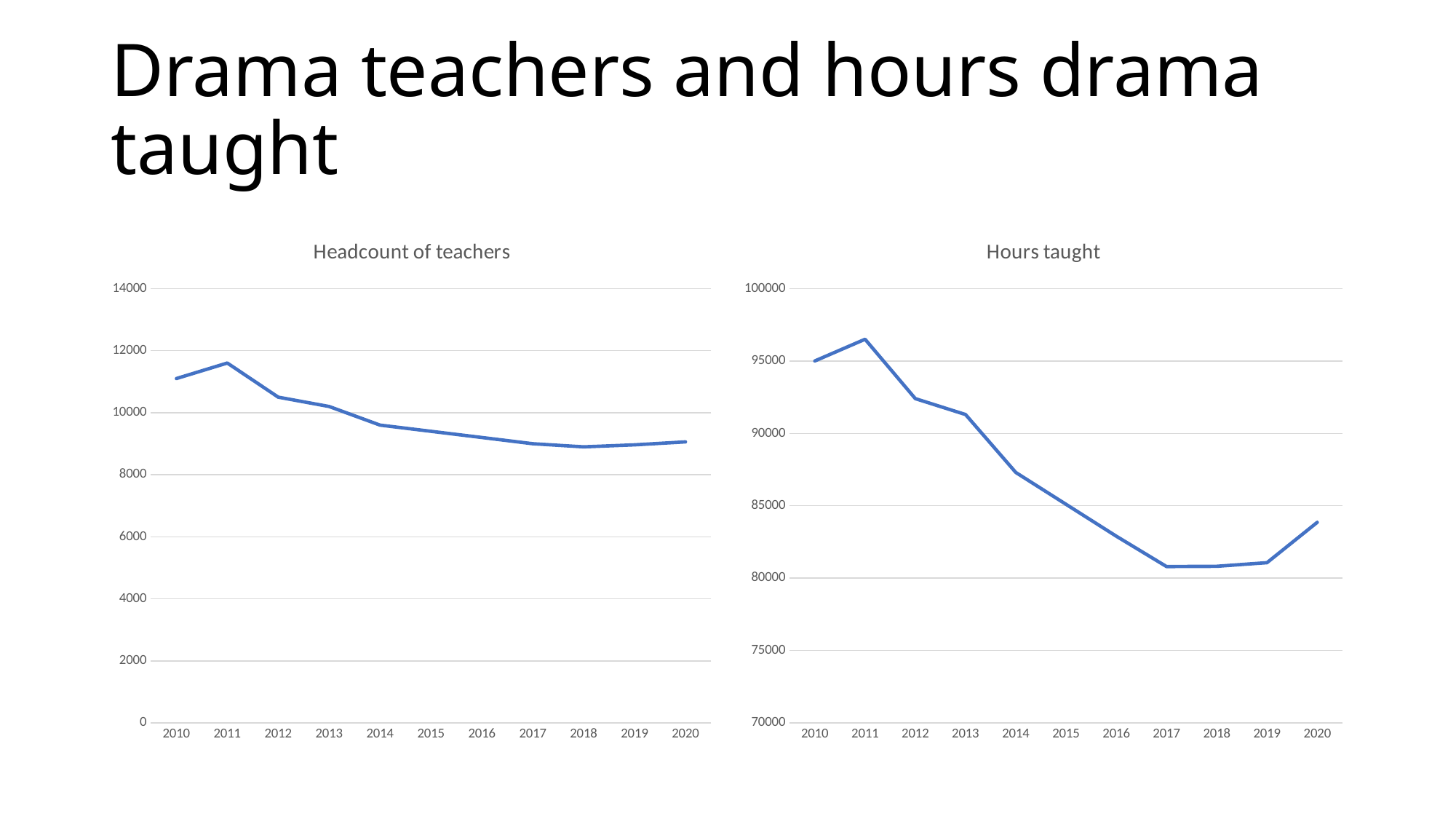
In the "Hours taught" chart, which is larger, the value for 2012 or the value for 2016? 2012 In the "Headcount of teachers" chart, is the value for 2014 greater or less than 10000? less In the "Hours taught" chart, which year has the highest value? 2011 What kind of chart is the "Hours taught" chart? line chart In the "Headcount of teachers" chart, is the value for 2010 greater or less than 10000? greater How many years are plotted on the x axis of the "Hours taught" chart? 11 In the "Headcount of teachers" chart, which is larger, the value for 2011 or the value for 2018? 2011 In the "Headcount of teachers" chart, which year has the highest value? 2011 What kind of chart is the "Headcount of teachers" chart? line chart In the "Hours taught" chart, is the value for 2014 greater or less than 85000? greater In the "Hours taught" chart, do the values rise or fall from 2011 to 2017? fall